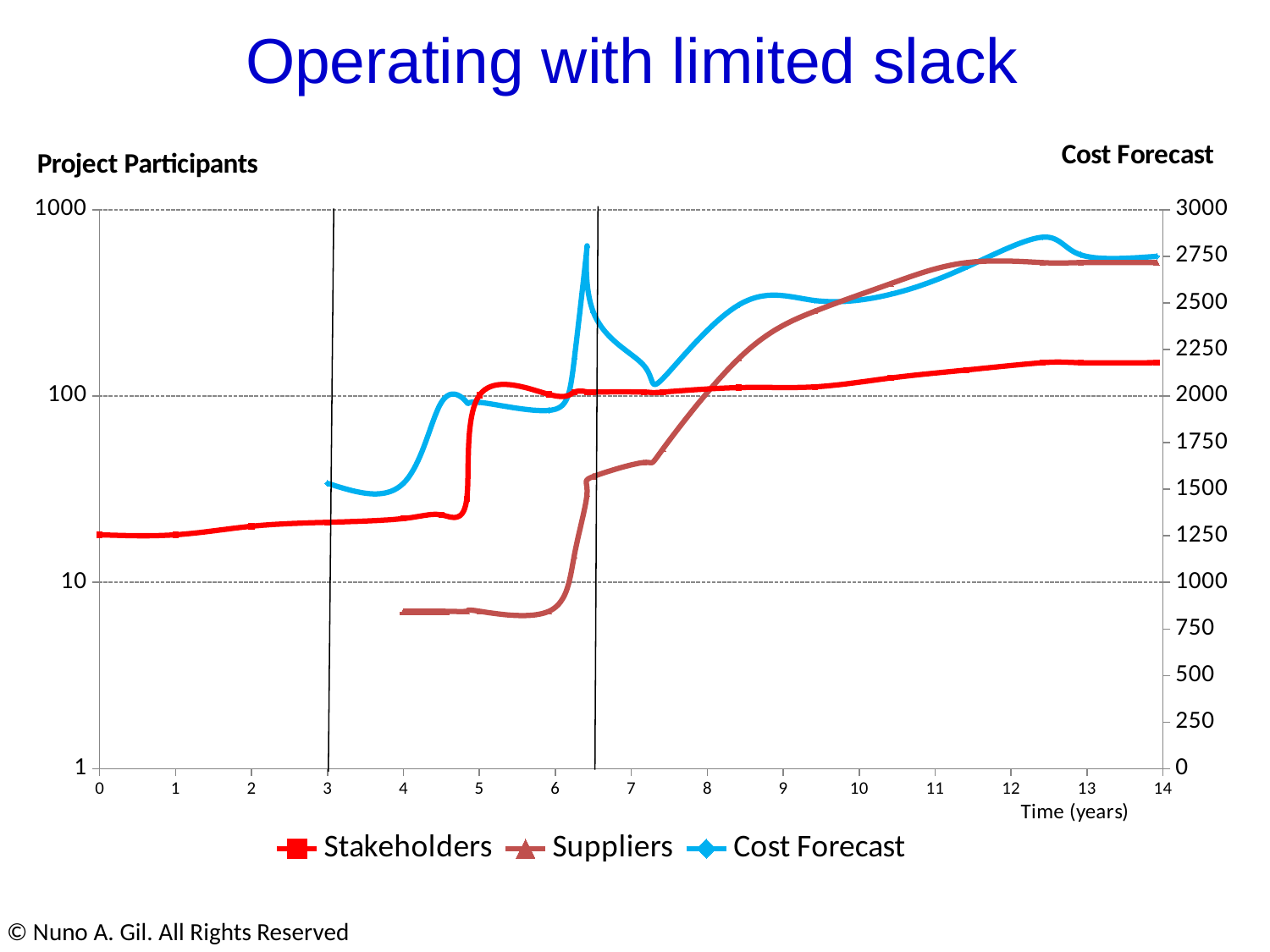
Is the value for Stakeholders at year 0 greater or less than 10? greater Is the value for Stakeholders at year 0 greater or less than 100? less Is the Cost Forecast value at year 14 greater or less than 2500? greater Does the Suppliers series generally rise or fall from year 4 to year 14? rise At year 14, which is higher: Stakeholders or Suppliers? Suppliers What is the title of the x axis? Time (years) What kind of chart is shown on the slide? line chart What label is shown above the left vertical axis? Project Participants How many series does the legend list? 3 At year 4, which is higher: Stakeholders or Suppliers? Stakeholders